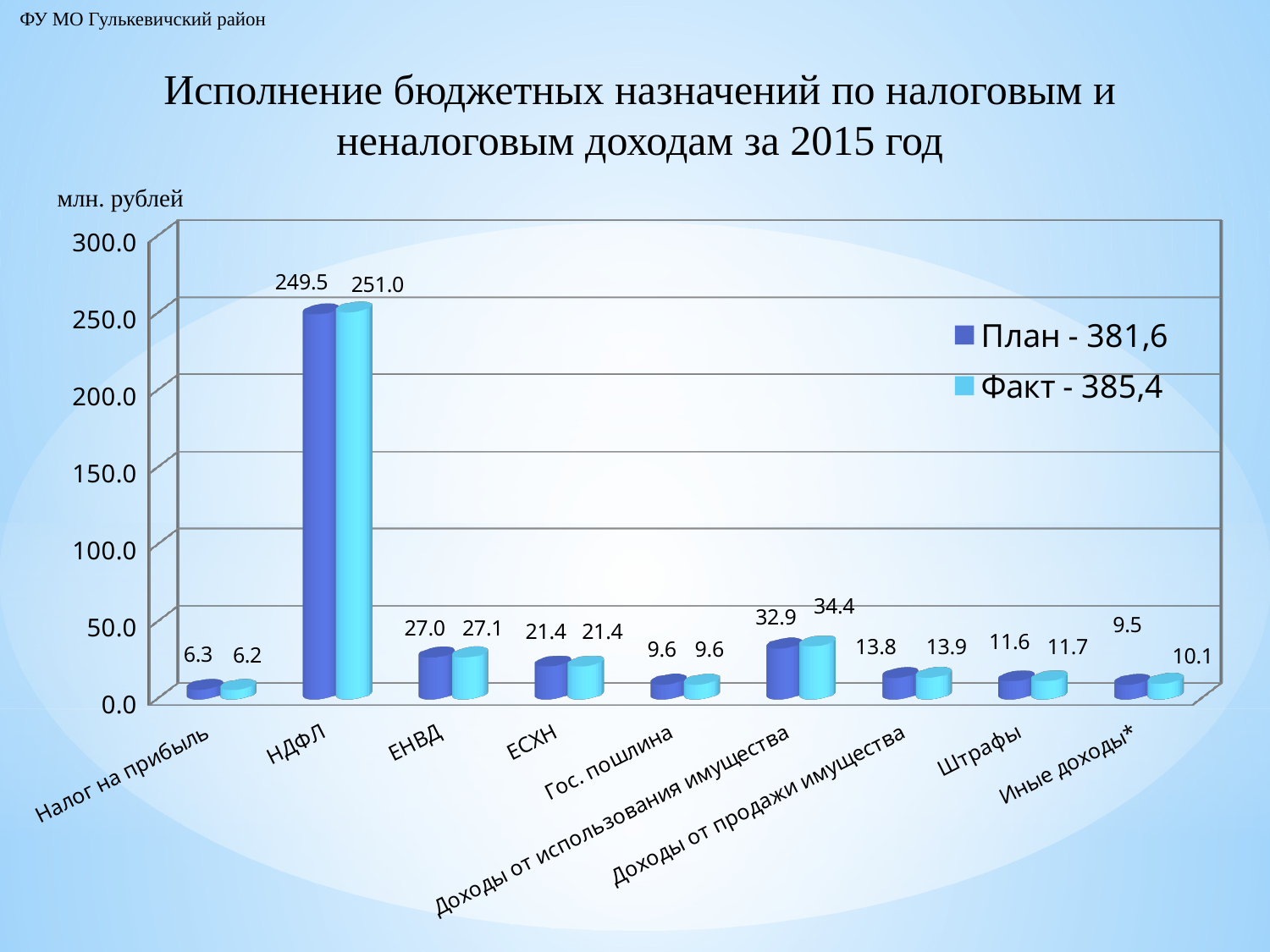
What kind of chart is shown on the slide? Bar chart How many series does the legend list? 2 What is the Факт value for Доходы от использования имущества? 34.4 Which category has the highest Факт value? НДФЛ Which is larger for Иные доходы*: the План value or the Факт value? Факт What is the План value for НДФЛ? 249.5 Which category has the lowest План value? Налог на прибыль What is the difference between the Факт and План values for НДФЛ? 1.5 What is the difference between the Факт and План values for Доходы от использования имущества? 1.5 What is the План value for Штрафы? 11.6 What is the Факт value for Иные доходы*? 10.1 How many categories are shown on the x axis? 9